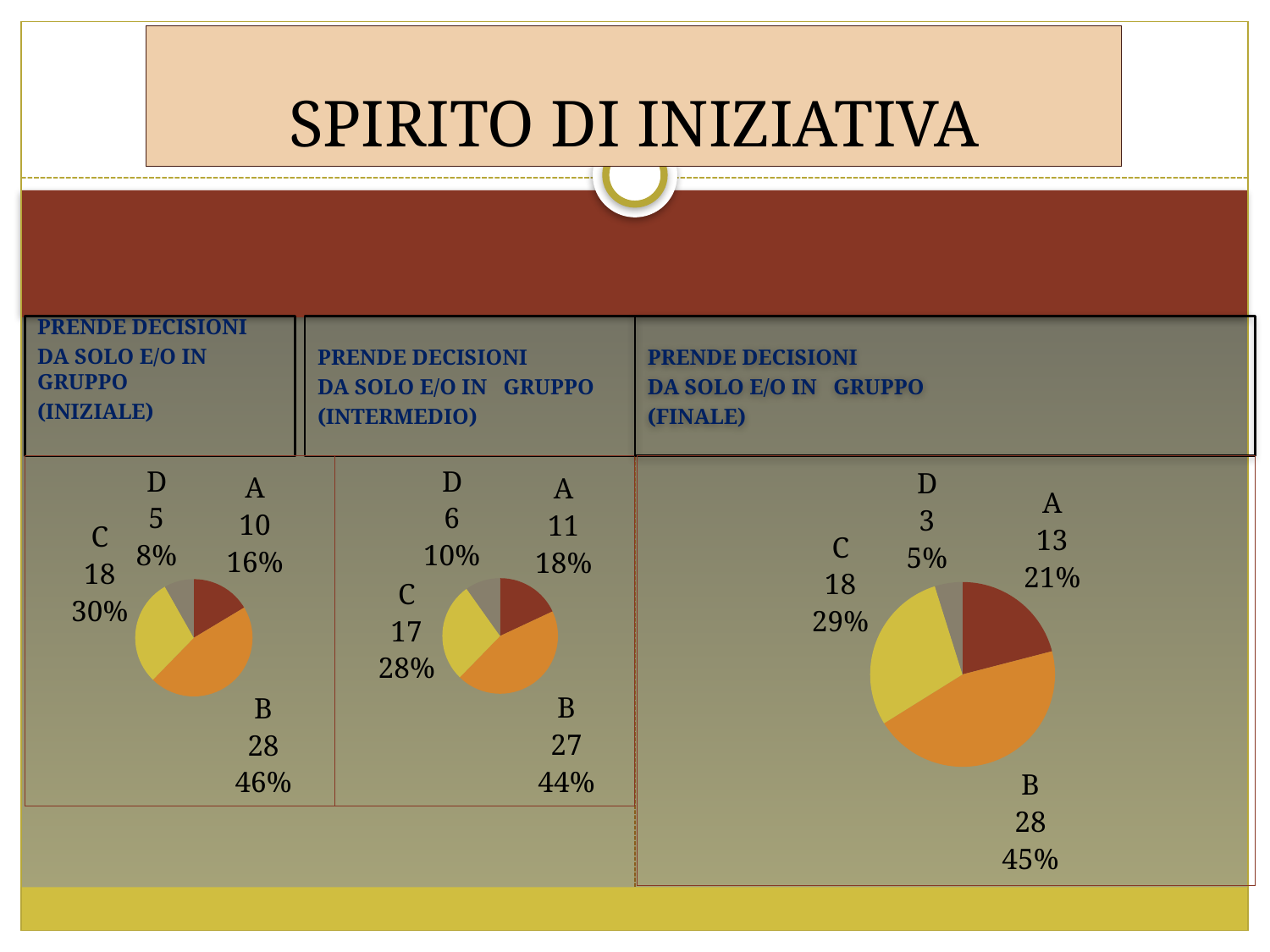
In the INTERMEDIO pie chart, what percentage share does category A have? 18% What type of chart is used in the FINALE panel? Pie chart In the INIZIALE pie chart, what percentage share does category C have? 30% How many categories does the INTERMEDIO pie chart show? 4 In the INIZIALE pie chart, which category has the smallest slice? D In the FINALE pie chart, what value is shown for category A? 13 In the INIZIALE pie chart, what value is shown for category B? 28 In the INTERMEDIO pie chart, what value is shown for category D? 6 In the FINALE pie chart, what percentage share does category D have? 5% In the FINALE pie chart, which is larger, the value for C or the value for A? C In the FINALE pie chart, which category has the largest slice? B In the INTERMEDIO pie chart, what is the difference between the values for B and C? 10